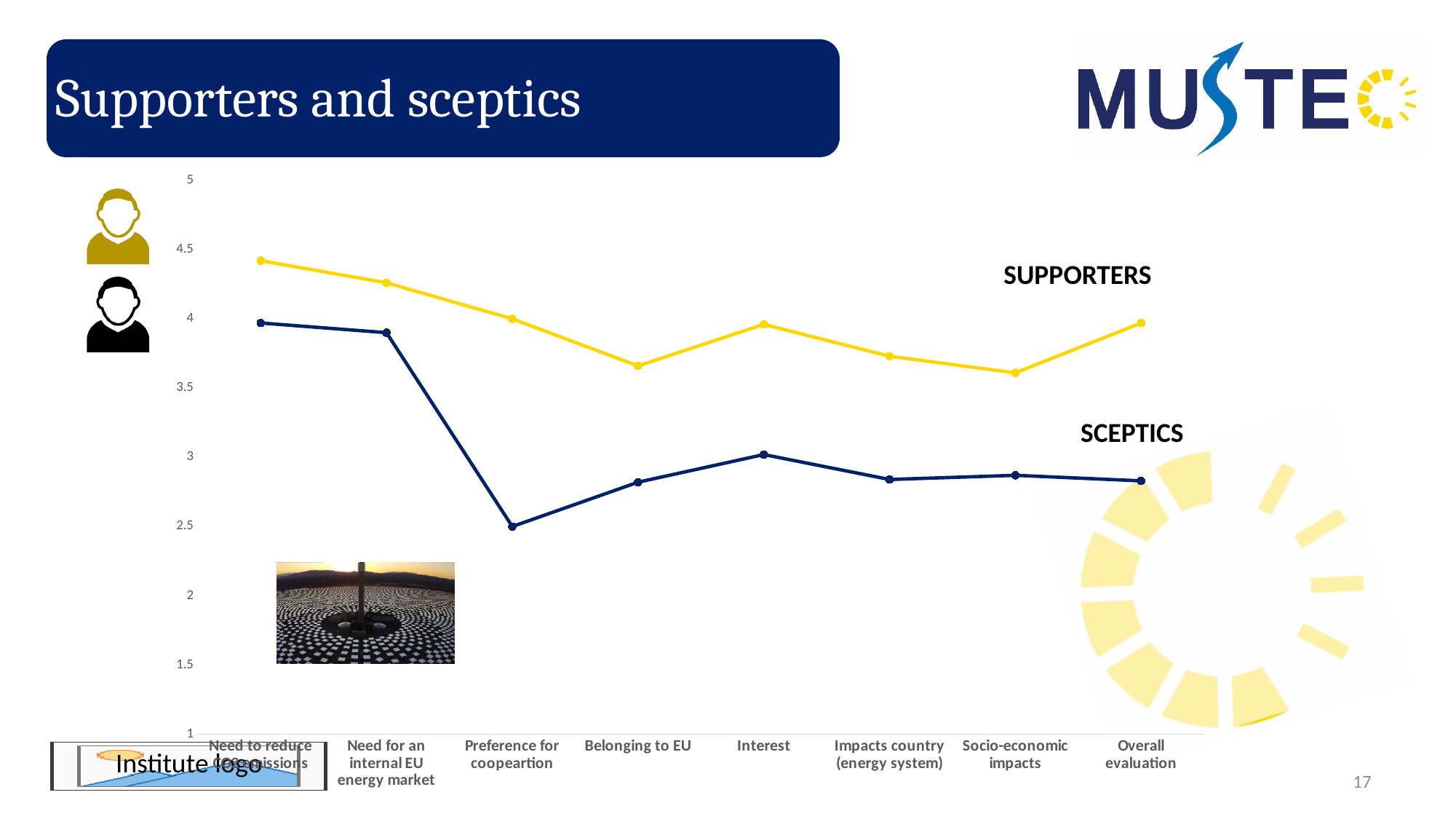
For which category is the SCEPTICS value lowest? Preference for coopeartion How many series are plotted on the chart? 2 Which series has the larger value for Preference for coopeartion, SUPPORTERS or SCEPTICS? SUPPORTERS Is the SCEPTICS value for Overall evaluation greater or less than 3? less Is the SUPPORTERS value for Interest greater or less than 3.5? greater Is the SUPPORTERS value for Need for an internal EU energy market greater or less than 4? greater What kind of chart is shown on the slide? Line chart Which series is drawn in yellow on the chart? SUPPORTERS Which series is drawn in dark blue on the chart? SCEPTICS How many categories are shown along the x axis of the chart? 8 Does the SCEPTICS line rise or fall from Need for an internal EU energy market to Preference for coopeartion? fall